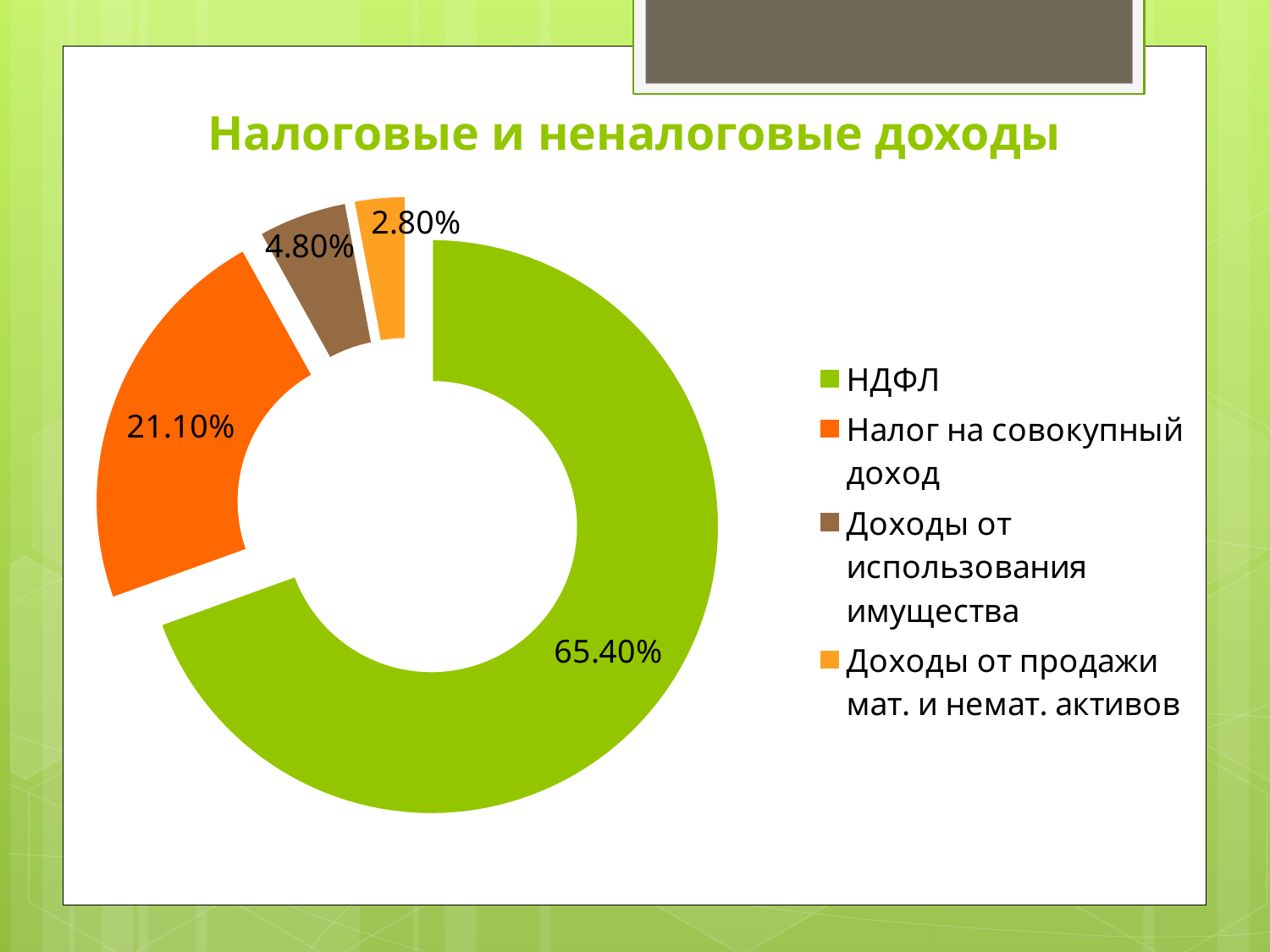
Which category has the largest share? НДФЛ What kind of chart is shown on the slide? Doughnut (pie) chart What is the difference between the shares of НДФЛ and Налог на совокупный доход? 44.30% What colour is the slice for Налог на совокупный доход? Orange What is the value for Налог на совокупный доход? 21.10% Which category has the smallest share? Доходы от продажи мат. и немат. активов What is the value for Доходы от использования имущества? 4.80% What is the value for Доходы от продажи мат. и немат. активов? 2.80% Which is larger: Доходы от использования имущества or Доходы от продажи мат. и немат. активов? Доходы от использования имущества How many categories does the chart show? 4 What is the title of the chart? Налоговые и неналоговые доходы What is the value for НДФЛ? 65.40%